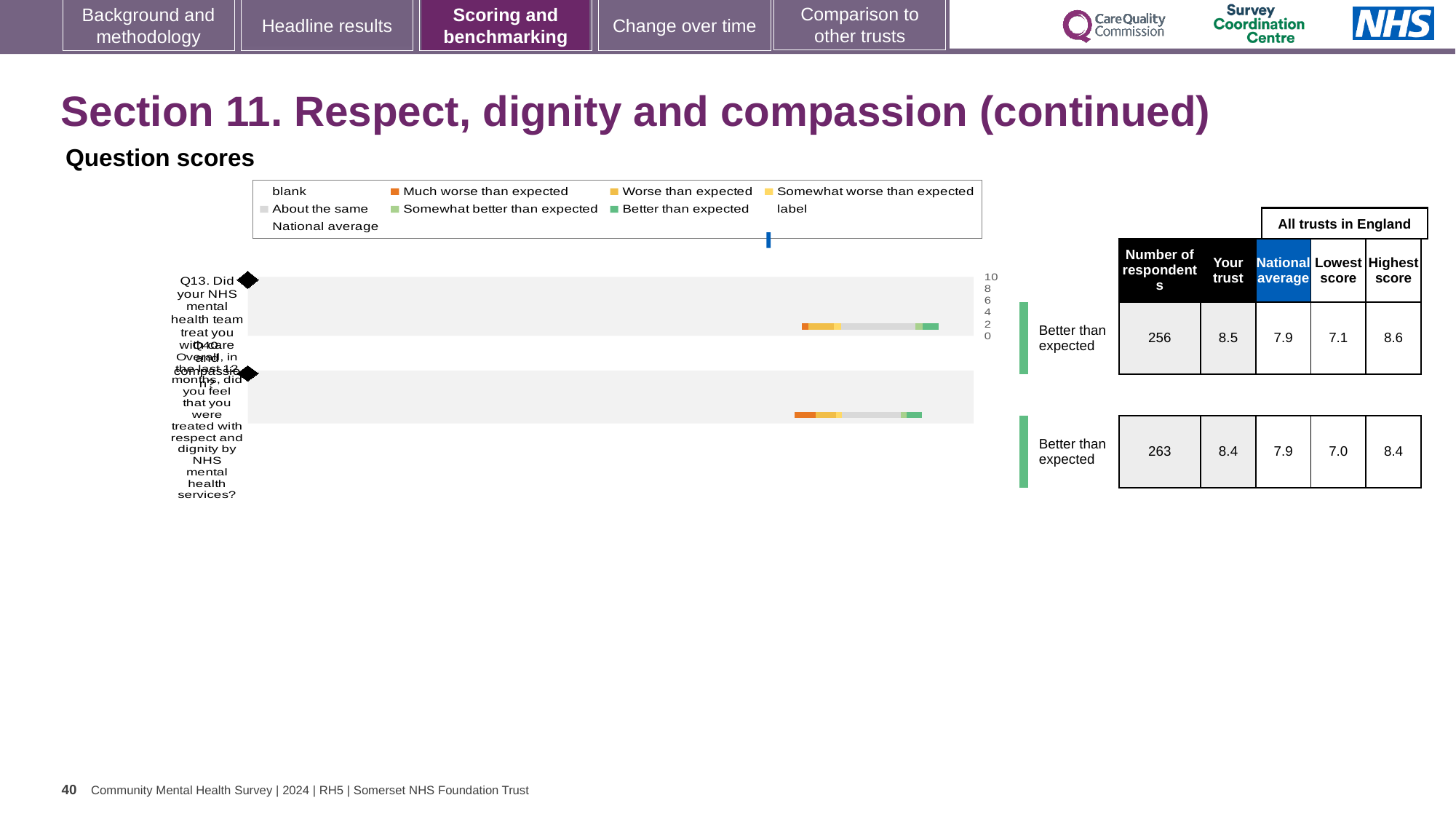
By how much does the 'Your trust' score for Q13 exceed the national average? 0.6 What is the lowest score across all trusts in England for Q40? 7.0 What is the highest score across all trusts in England for Q13? 8.6 For Q13, which is larger: the 'Your trust' score or the national average? Your trust How many respondents are shown for Q40? 263 What kind of chart is used to show the question scores on this slide? bar chart What is the national average score for Q13? 7.9 Which benchmark category is shown next to the Q13 bar? Better than expected What colour does the legend use for 'Much worse than expected'? orange What is the 'Your trust' score for Q13? 8.5 How many questions are plotted in the question scores chart? 2 What is the difference between the highest score and the lowest score for Q40? 1.4